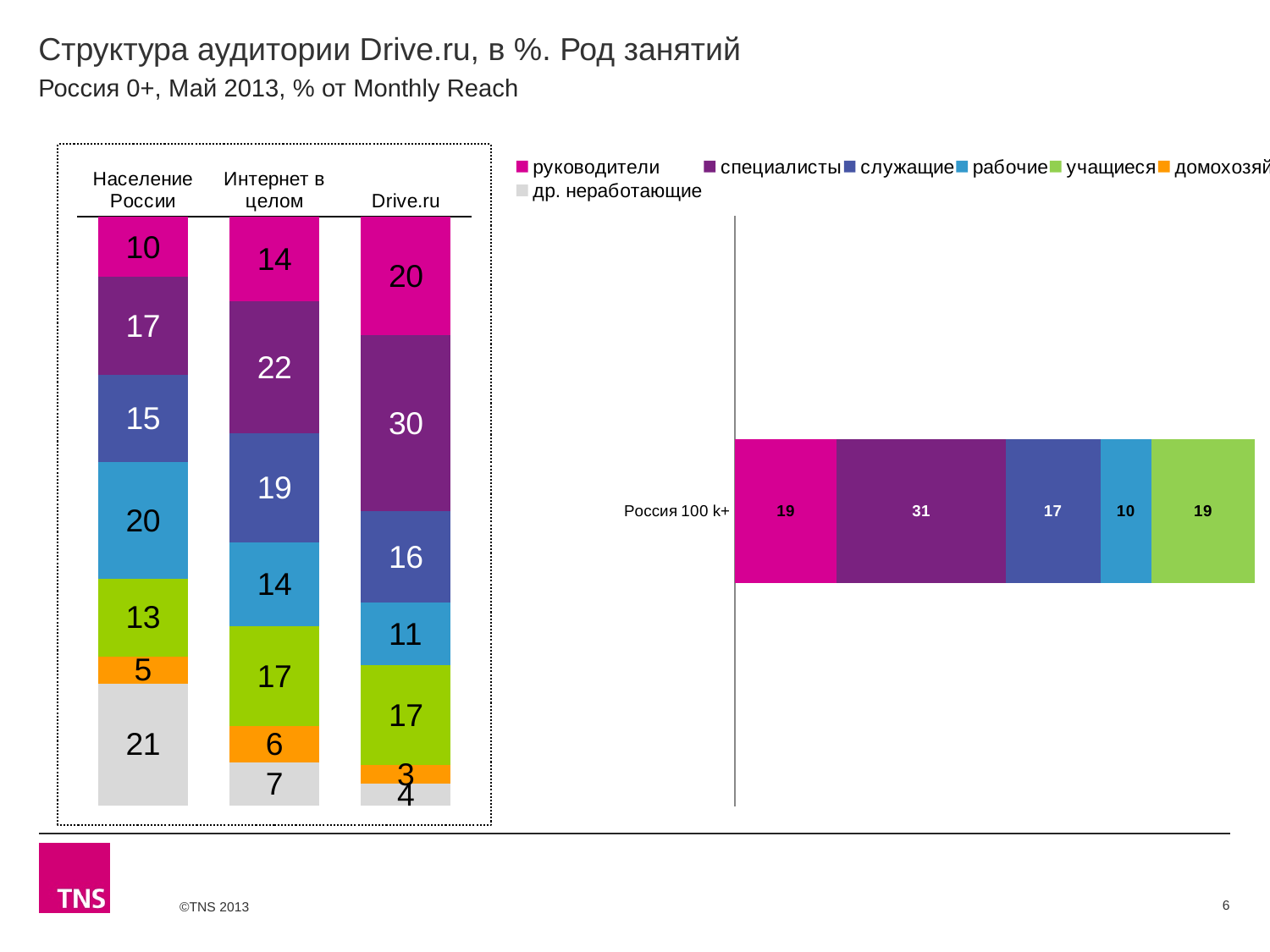
In the right chart, what is the value for специалисты in the Россия 100 k+ bar? 31 How many bars (categories) are shown in the left chart? 3 What kind of chart is the right chart? Stacked bar chart In the left chart, what is the value for специалисты in the Drive.ru bar? 30 In the left chart, what is the value for др. неработающие in the Население России bar? 21 In the left chart, what is the value for служащие in the Интернет в целом bar? 19 In the left chart, which of the three bars has the lowest value for рабочие? Drive.ru In the left chart, is the учащиеся value larger for Население России or for Интернет в целом? Интернет в целом In the left chart, which of the three bars has the highest value for руководители? Drive.ru How many series does the legend list? 7 In the right chart, what is the total of the Россия 100 k+ bar? 96 In the left chart, what is the difference between the специалисты values for Drive.ru and Население России? 13